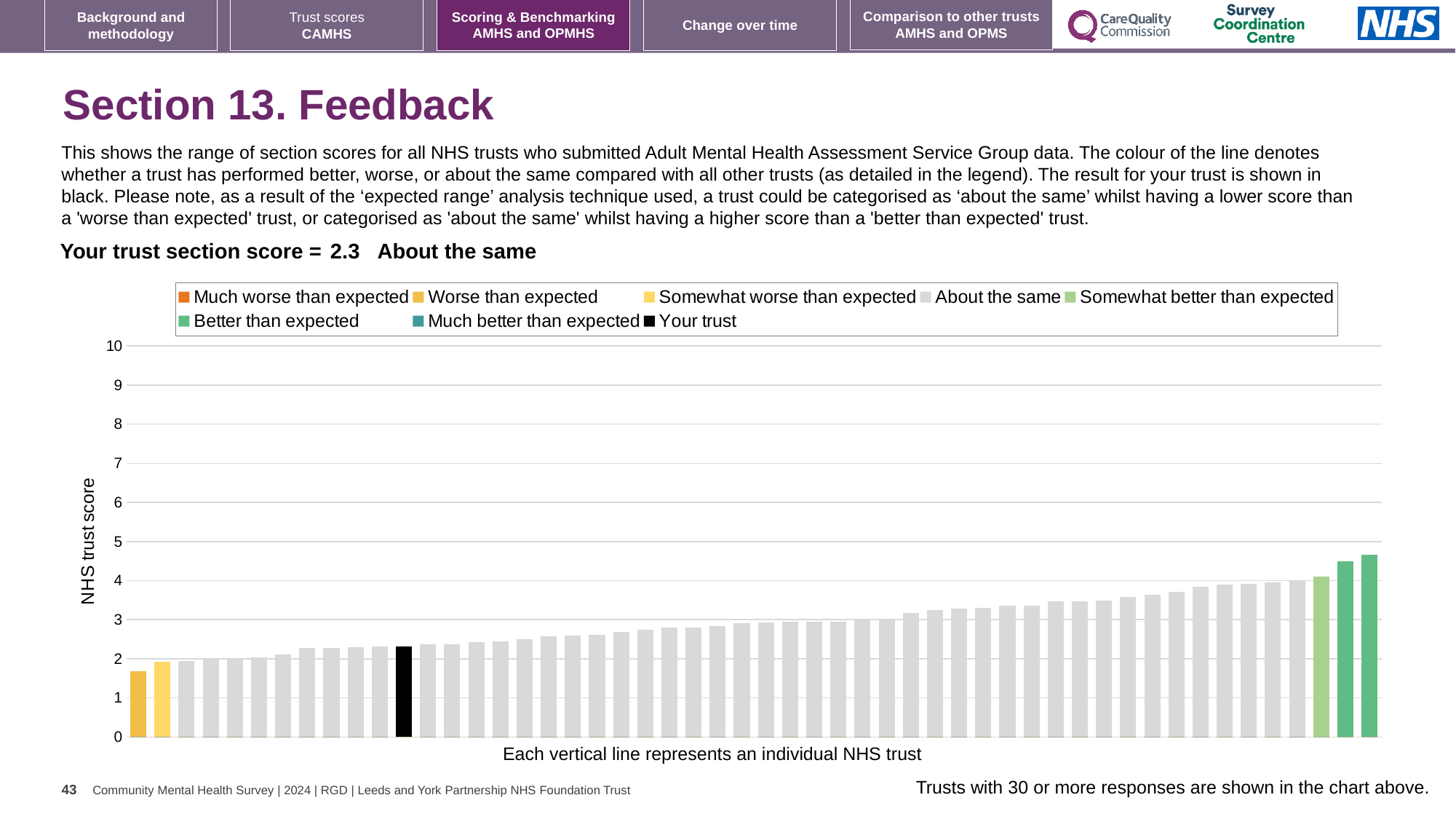
What is the label on the vertical axis of the chart? NHS trust score What kind of chart is shown on the slide? bar chart Is the value for your trust (the black bar) greater or less than 3? less Which is larger: the value for your trust (black bar) or the value for the leftmost bar? Your trust Is the value for the lowest bar in the chart greater or less than 2? less Is the value for the highest bar in the chart greater or less than 4? greater Which legend category do the two rightmost (highest) bars belong to? Better than expected What is your trust's section score for Section 13. Feedback? 2.3 Which legend category does the leftmost (lowest) bar belong to? Worse than expected What colour is used in the legend for 'Your trust'? black Which category is your trust's section score placed in? About the same How many entries does the chart legend list? 8